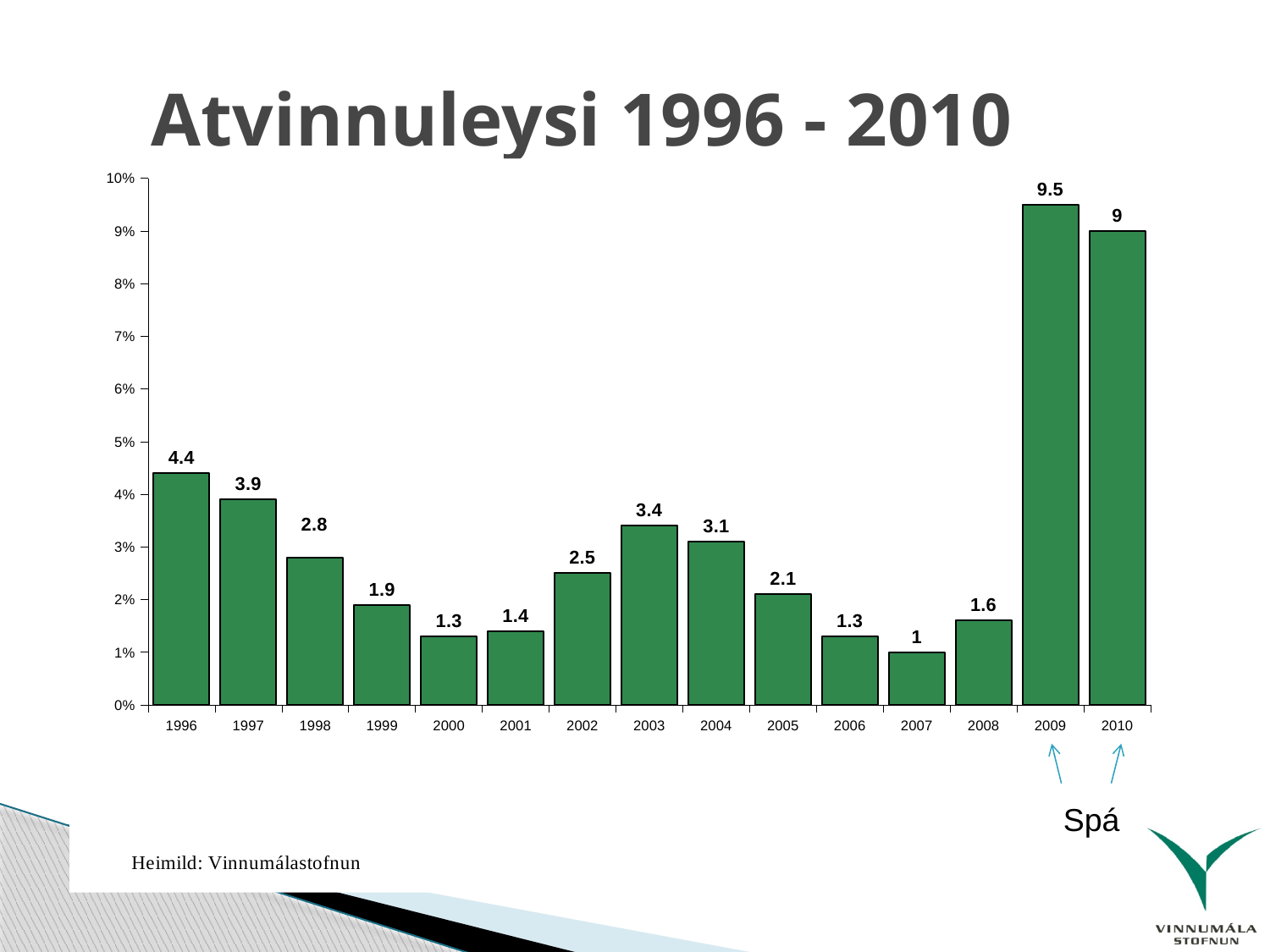
What kind of chart is shown on the slide? bar chart How many years are shown on the x axis? 15 Do the values rise or fall from 1996 to 2000? fall Which is larger, the value for 1997 or the value for 2004? 1997 Which year has the lowest value? 2007 What is the value for 2010? 9 Is the value for 2002 greater or less than 2%? greater What is the value for 2003? 3.4 What is the title of the chart? Atvinnuleysi 1996 - 2010 Which year has the highest value? 2009 What is the difference between the values for 2009 and 2008? 7.9 What is the value for 1996? 4.4